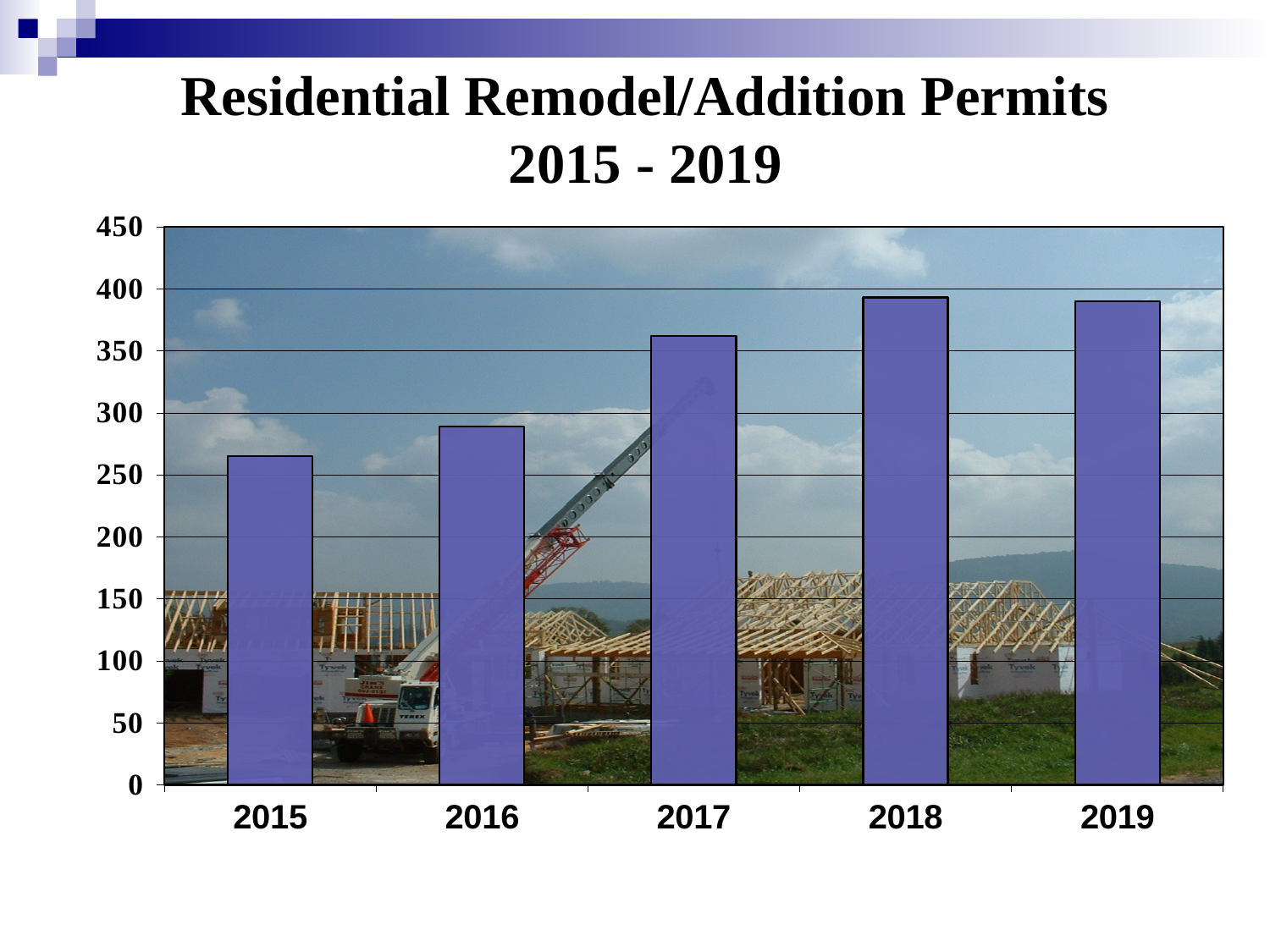
What is the title of the chart? Residential Remodel/Addition Permits 2015 - 2019 Is the value for 2019 greater or less than 350? greater Is the value for 2017 greater or less than 350? greater Is the value for 2016 greater or less than 300? less Do the values rise or fall from 2015 to 2018? rise Which year has the lowest number of residential remodel/addition permits? 2015 Which is larger, the value for 2016 or the value for 2017? 2017 How many years are shown on the x axis of the chart? 5 Which is larger, the value for 2015 or the value for 2019? 2019 What kind of chart is shown on the slide? bar chart